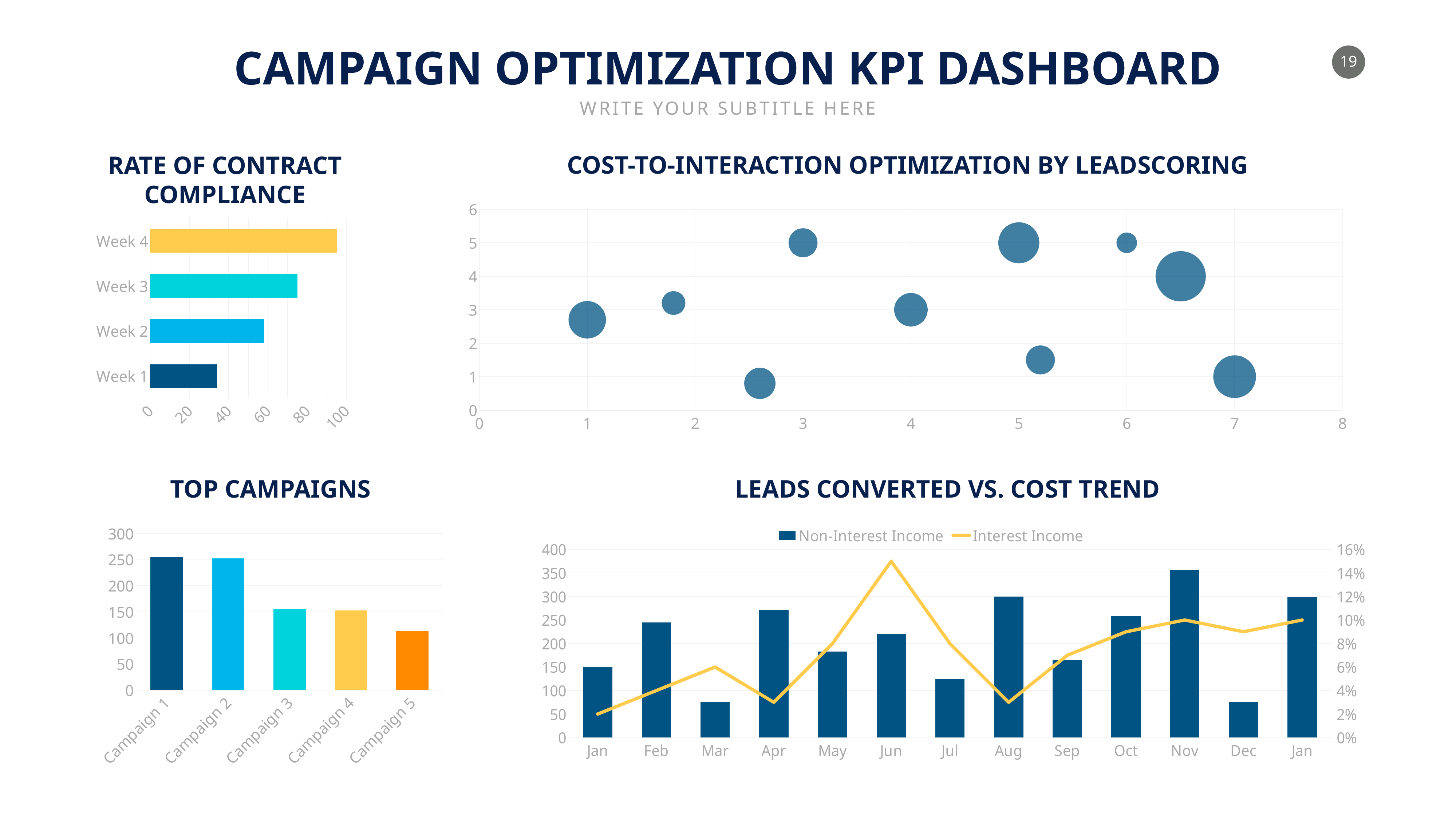
In the Leads Converted vs. Cost Trend chart, which month has the highest Non-Interest Income bar? Nov In the Top Campaigns chart, which is larger, Campaign 1 or Campaign 3? Campaign 1 What kind of chart is the Cost-to-Interaction Optimization by Leadscoring chart? bubble chart How many series does the legend of the Leads Converted vs. Cost Trend chart list? 2 In the Top Campaigns chart, which campaign has the lowest value? Campaign 5 In the Rate of Contract Compliance chart, is the value for Week 4 greater or less than 80? greater How many bubbles are plotted in the Cost-to-Interaction Optimization by Leadscoring chart? 10 In the Leads Converted vs. Cost Trend chart, in which month does the Interest Income line reach its peak? Jun In the Rate of Contract Compliance chart, is the value for Week 1 greater or less than 40? less In the Top Campaigns chart, is the value for Campaign 5 greater or less than 150? less In the Rate of Contract Compliance chart, which week has the lowest value? Week 1 In the Rate of Contract Compliance chart, which week has the highest value? Week 4